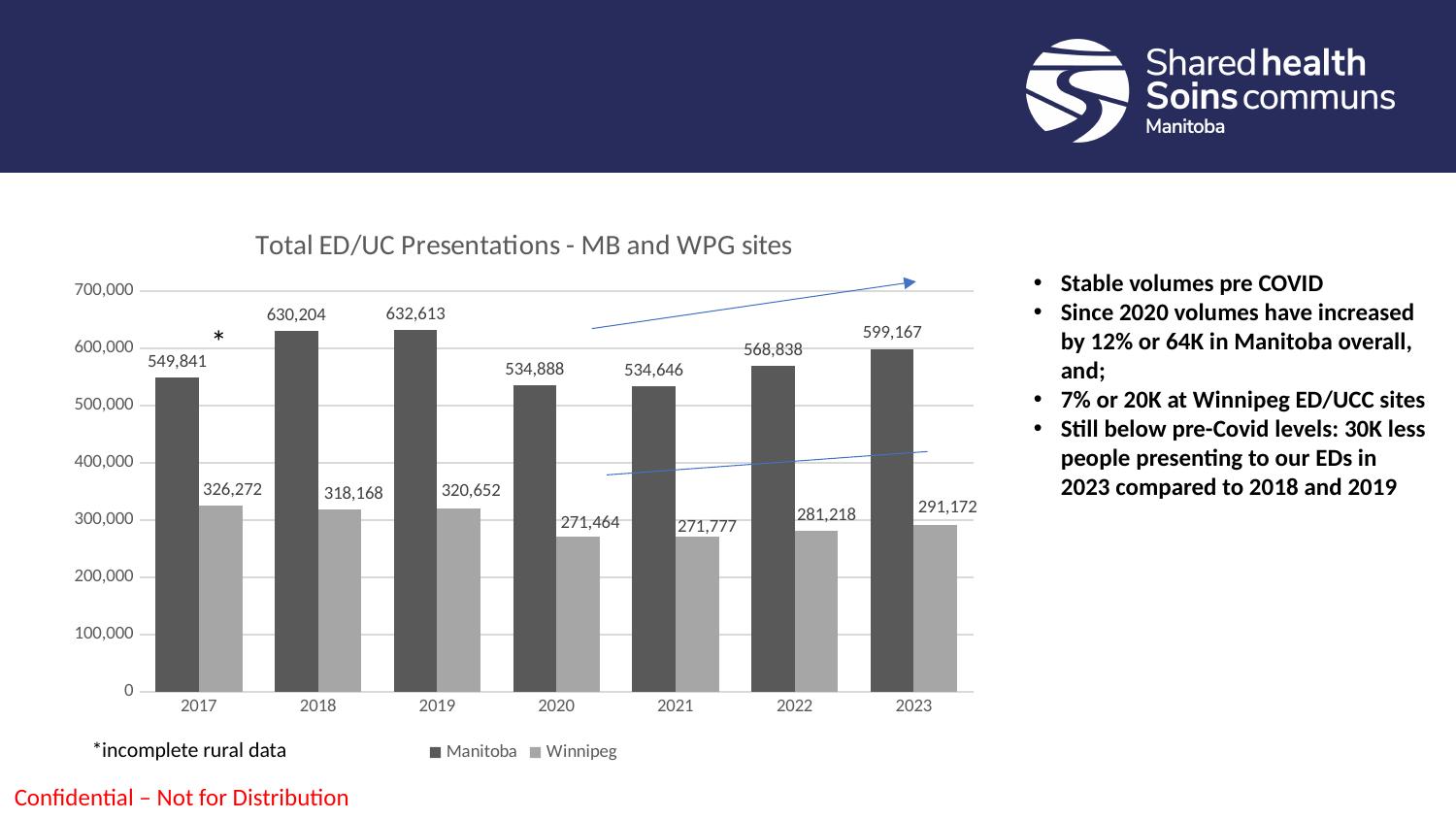
Which is larger, the Manitoba value for 2018 or the Manitoba value for 2023? 2018 What is the Winnipeg value for 2022? 281,218 What is the difference between the Manitoba values for 2023 and 2022? 30,329 Is the Winnipeg value for 2020 greater or less than 300,000? less What is the title of the chart? Total ED/UC Presentations - MB and WPG sites How many series does the legend list? 2 What type of chart is shown on the slide? Bar chart In which year is the Manitoba value highest? 2019 What is the Manitoba value for 2019? 632,613 How many years are shown on the x axis? 7 Do the Manitoba values rise or fall from 2020 to 2023? rise In which year is the Winnipeg value highest? 2017